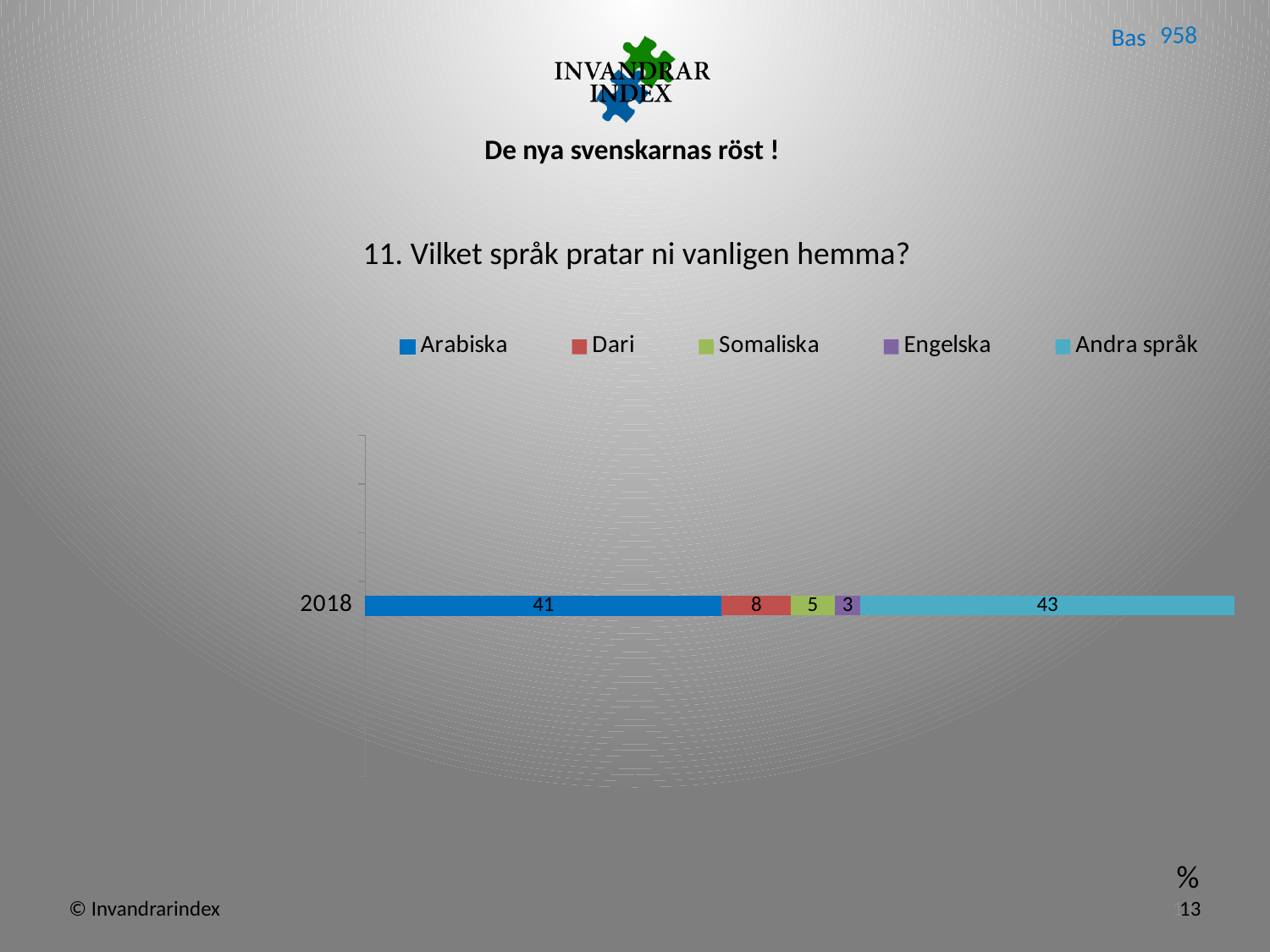
What is the difference between the values for Arabiska and Dari in 2018? 33 Which is larger in 2018, Dari or Somaliska? Dari What is the value for Andra språk in 2018? 43 What is the value for Arabiska in 2018? 41 What is the total of the stacked bar for 2018? 100 What is the value for Somaliska in 2018? 5 Which series has the highest value in 2018? Andra språk What is the value for Engelska in 2018? 3 What is the value for Dari in 2018? 8 Which series has the lowest value in 2018? Engelska How many series does the legend list? 5 What kind of chart is shown on the slide? Stacked bar chart